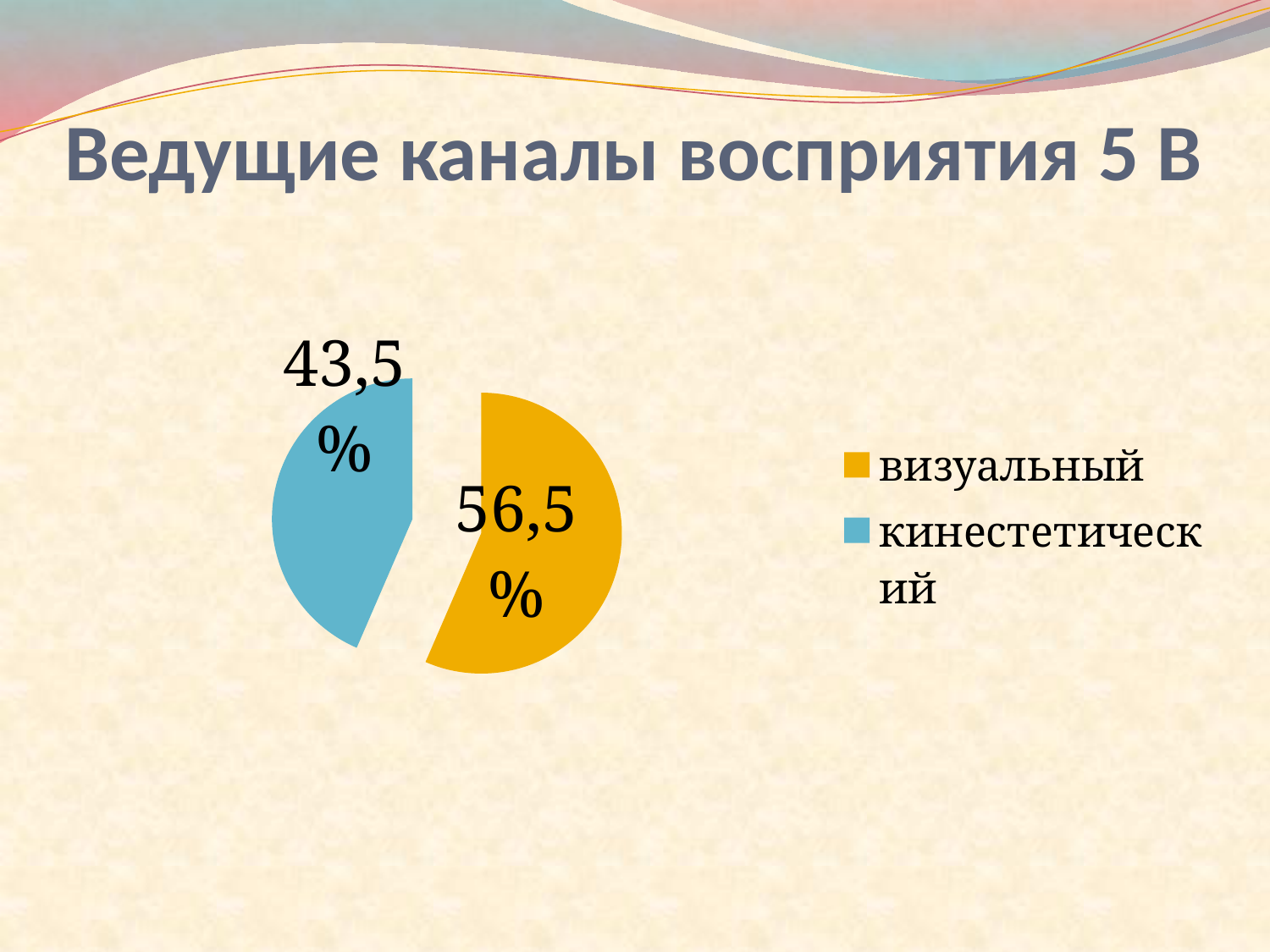
Which is larger, визуальный or кинестетический? визуальный What is the value for визуальный? 56,5% Which category has the largest share of the pie? визуальный Which category has the smallest share of the pie? кинестетический How many entries does the legend list? 2 What is the difference between the values for визуальный and кинестетический? 13% What is the title of the slide containing the chart? Ведущие каналы восприятия 5 В What colour is the slice for кинестетический? blue What kind of chart is shown on the slide? pie chart What is the value for кинестетический? 43,5% How many slices does the pie chart have? 2